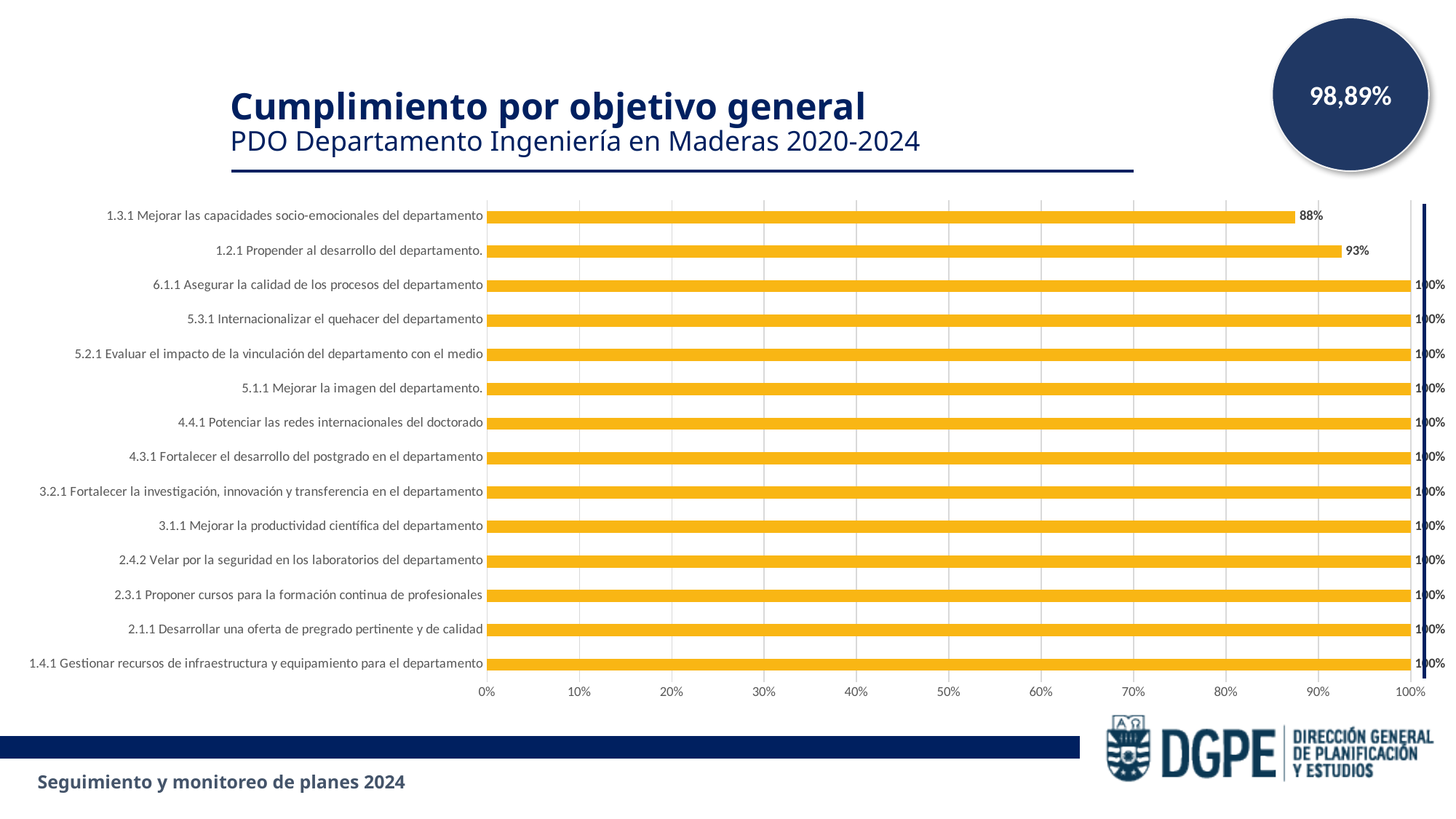
How many objectives are shown in the chart? 14 What is the value for 2.1.1 Desarrollar una oferta de pregrado pertinente y de calidad? 100% What is the value for 1.3.1 Mejorar las capacidades socio-emocionales del departamento? 88% What is the value for 1.2.1 Propender al desarrollo del departamento? 93% What kind of chart is shown on the slide? Bar chart Is the value for 1.2.1 Propender al desarrollo del departamento greater or less than 90%? greater Which has a larger value, 1.2.1 Propender al desarrollo del departamento or 1.3.1 Mejorar las capacidades socio-emocionales del departamento? 1.2.1 Propender al desarrollo del departamento What is the difference between the values for 1.2.1 Propender al desarrollo del departamento and 1.3.1 Mejorar las capacidades socio-emocionales del departamento? 5% How many objectives have a value of 100%? 12 Is the value for 1.3.1 Mejorar las capacidades socio-emocionales del departamento greater or less than 90%? less Which objective has the lowest value? 1.3.1 Mejorar las capacidades socio-emocionales del departamento What overall percentage is shown in the circle at the top right of the slide? 98,89%